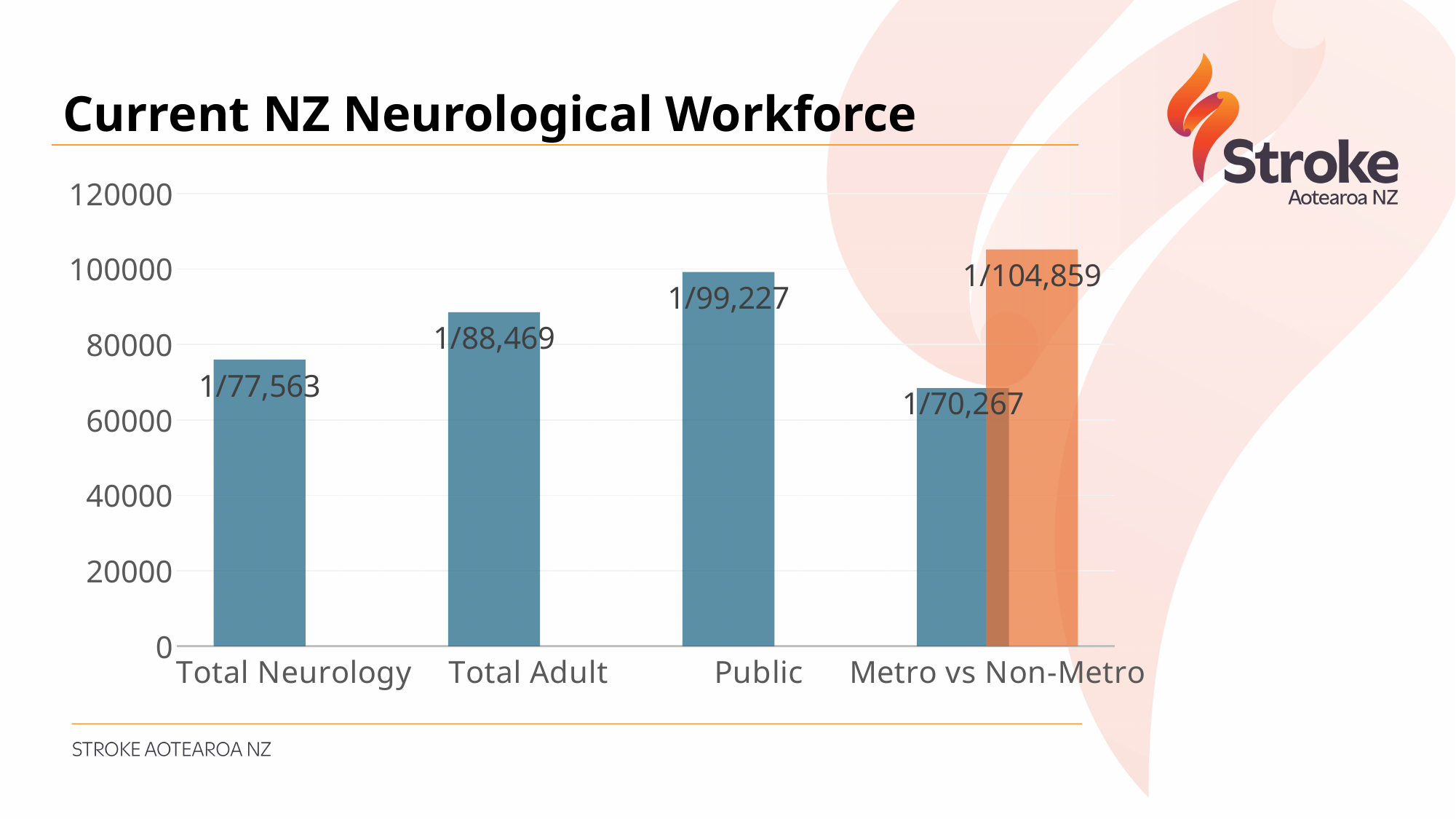
Which is larger, the value for Total Adult or the value for Public? Public Which bar on the chart is the tallest? The orange Non-Metro bar (1/104,859) What is the title of the chart on the slide? Current NZ Neurological Workforce What value is labelled on the orange (Non-Metro) bar in the Metro vs Non-Metro category? 1/104,859 Is the value for Total Neurology greater or less than 80000? less How many categories are shown on the x axis? 4 What value is labelled on the Public bar? 1/99,227 Which bar on the chart is the shortest? The blue Metro bar (1/70,267) What value is labelled on the blue (Metro) bar in the Metro vs Non-Metro category? 1/70,267 What kind of chart is shown on the slide? Bar chart What value is labelled on the Total Neurology bar? 1/77,563 What value is labelled on the Total Adult bar? 1/88,469